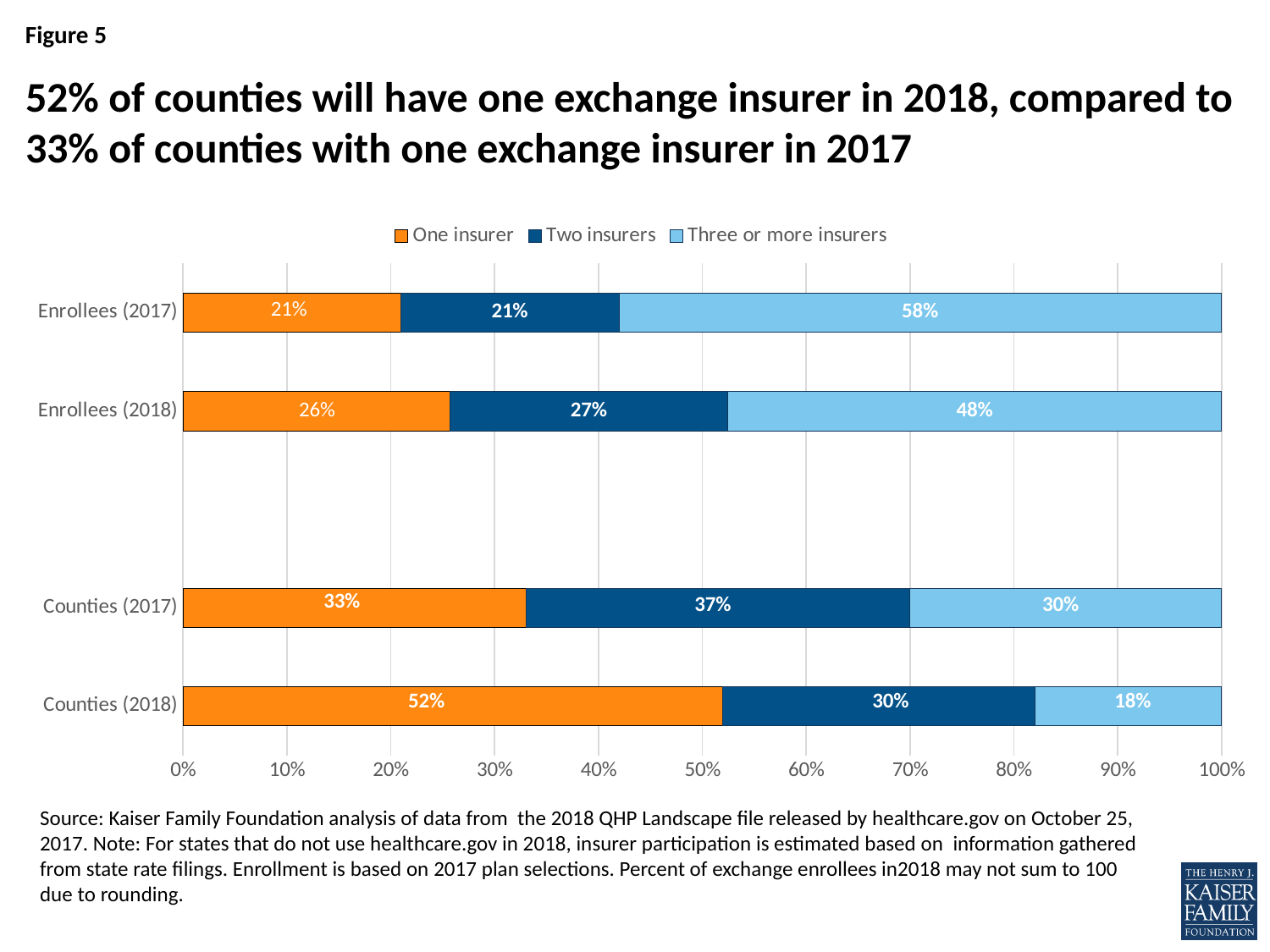
What percentage of counties in 2018 have one insurer? 52% How many series does the legend list? 3 What is the difference between the One insurer share for Counties (2018) and Counties (2017)? 19 percentage points Which category has the lowest value for Three or more insurers? Counties (2018) What is the value for Two insurers in the Counties (2017) bar? 37% What is the value for Three or more insurers in the Enrollees (2018) bar? 48% What percentage of enrollees in 2017 have three or more insurers? 58% Which is larger: the Two insurers share for Enrollees (2018) or for Enrollees (2017)? Enrollees (2018) How many categories are shown on the y axis? 4 Which category has the highest value for One insurer? Counties (2018) Which colour represents One insurer in the legend? Orange What kind of chart is shown? Stacked bar chart